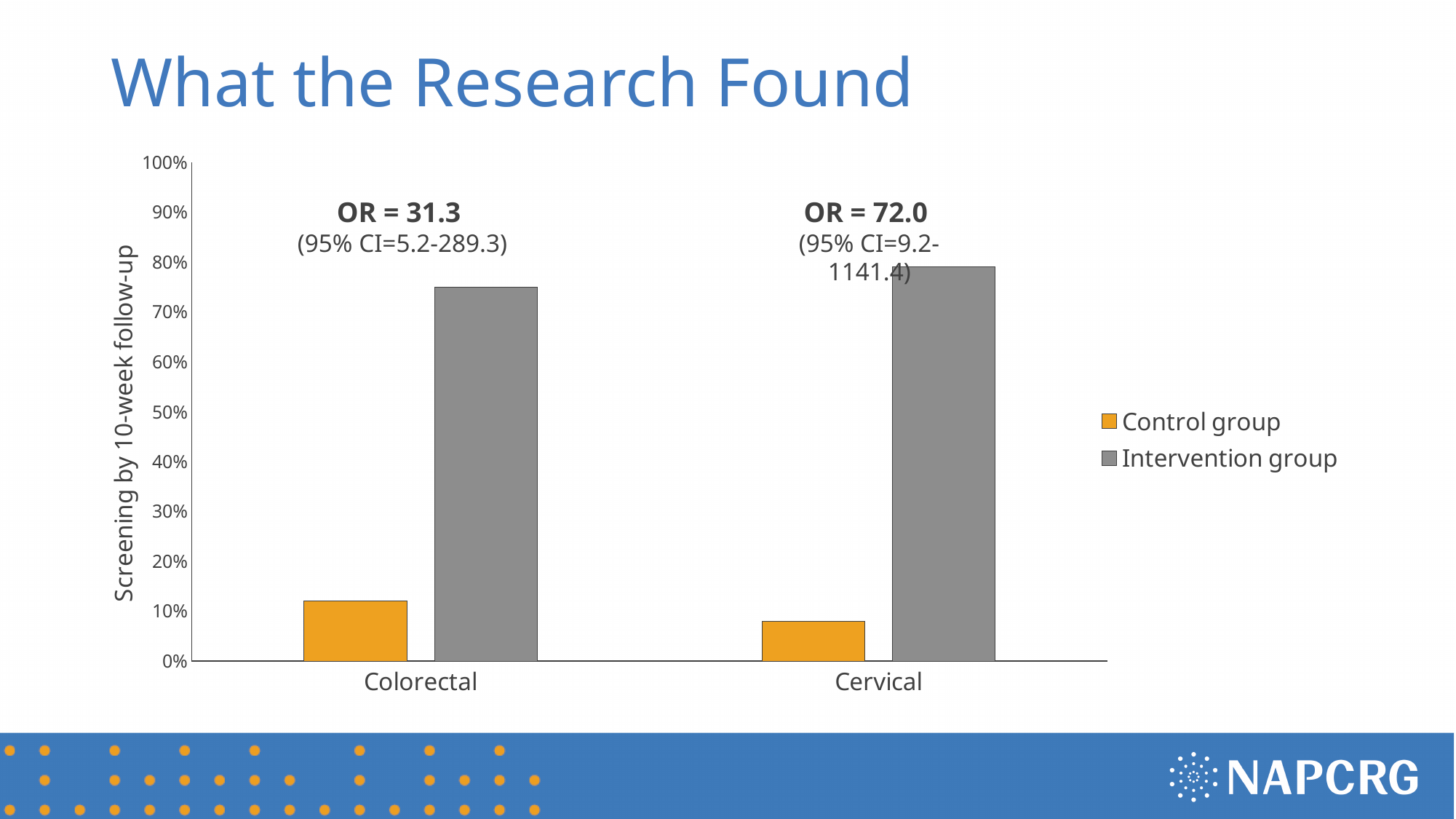
Is the Control group value for Colorectal greater or less than 20%? less What is the odds ratio (OR) printed above the Cervical bars? OR = 72.0 Is the Intervention group value for Colorectal greater or less than 70%? greater What is the odds ratio (OR) printed above the Colorectal bars? OR = 31.3 Which category has the higher Control group value, Colorectal or Cervical? Colorectal For Cervical screening, which group has the higher value, Control group or Intervention group? Intervention group Is the Control group value for Cervical greater or less than 10%? less What 95% confidence interval is printed for the Colorectal odds ratio? 5.2-289.3 How many series does the legend list? 2 How many categories are shown on the x axis? 2 What is the label on the vertical axis? Screening by 10-week follow-up What kind of chart is shown on the slide? bar chart